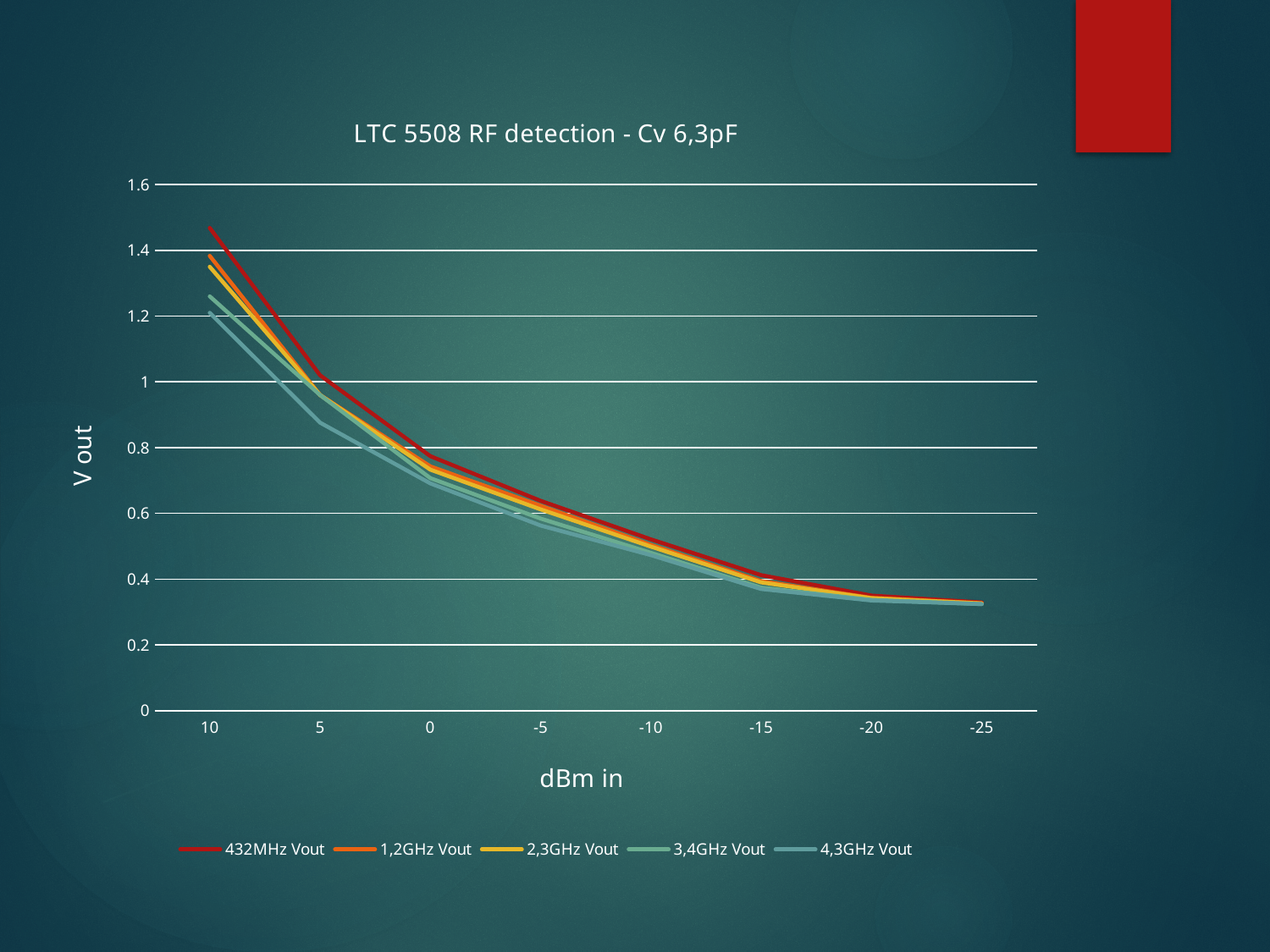
How many series does the legend list? 5 How many dBm in values are plotted along the x axis? 8 Which series has the highest V out at 10 dBm in? 432MHz Vout What kind of chart is shown on the slide? line chart At 10 dBm in, which is larger: 432MHz Vout or 4,3GHz Vout? 432MHz Vout Is the value for 3,4GHz Vout at 10 dBm in greater or less than 1.2? greater Is the value for 4,3GHz Vout at 5 dBm in greater or less than 1? less Is the value for 432MHz Vout at -25 dBm in greater or less than 0.4? less Which series has the lowest V out at 10 dBm in? 4,3GHz Vout Do the V out values rise or fall as dBm in goes from 10 to -25 along the x axis? fall What is the title of the chart? LTC 5508 RF detection - Cv 6,3pF